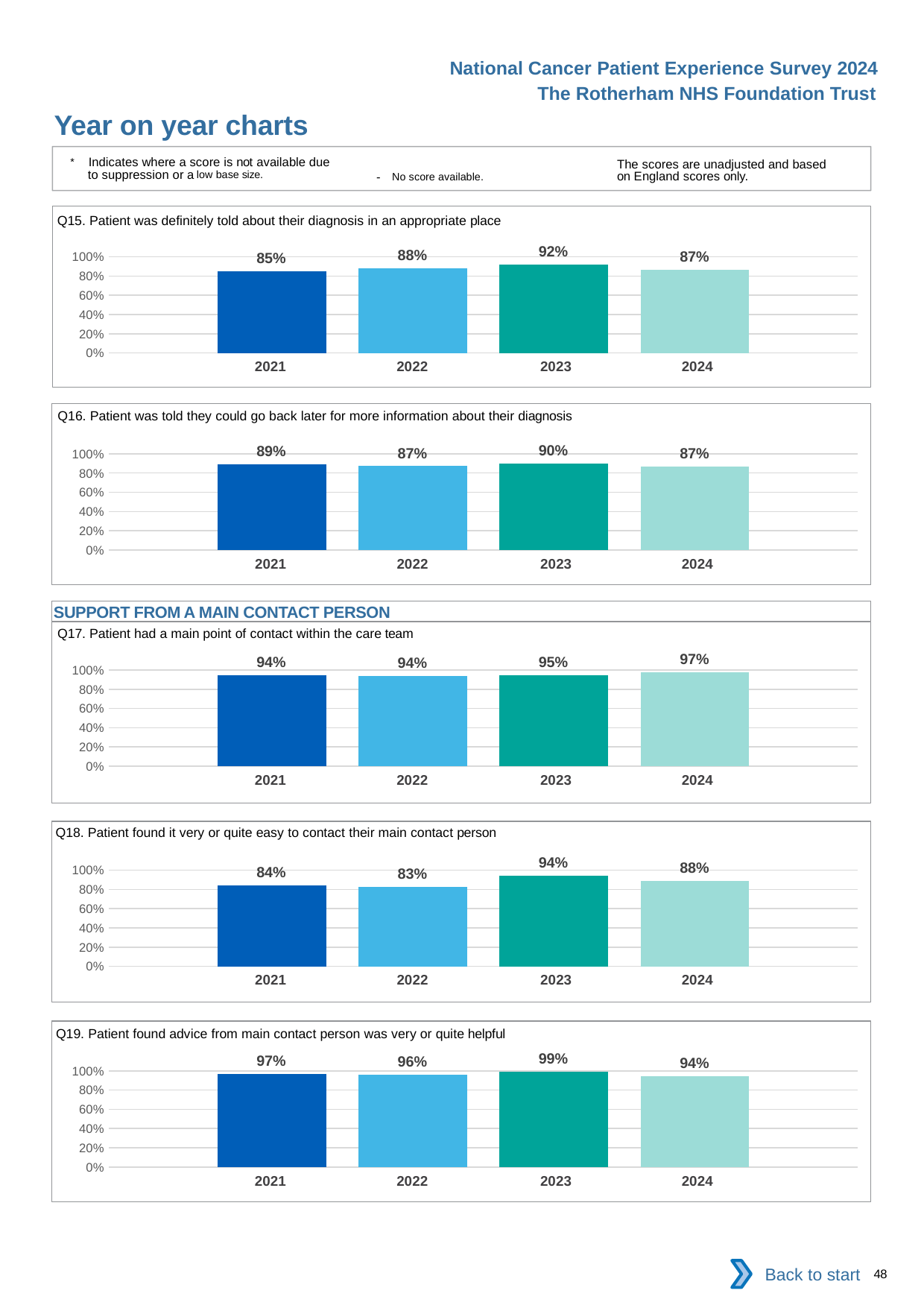
In the Q18 chart, what is the difference between the 2023 value and the 2022 value? 11% In the Q15 chart (patient was definitely told about their diagnosis in an appropriate place), what is the value for 2023? 92% In the Q16 chart, which year has the highest value? 2023 How many years are shown in the Q19 chart? 4 In the Q19 chart (patient found advice from main contact person was very or quite helpful), what is the value for 2023? 99% In the Q18 chart (patient found it very or quite easy to contact their main contact person), what is the value for 2022? 83% In the Q15 chart, which year has the lowest value? 2021 In the Q17 chart (patient had a main point of contact within the care team), what is the value for 2024? 97% What kind of chart is the Q15 chart? Bar chart In the Q16 chart (patient was told they could go back later for more information about their diagnosis), what is the value for 2021? 89% In the Q17 chart, what is the difference between the 2024 value and the 2021 value? 3% In the Q18 chart, which is larger, the value for 2023 or the value for 2024? 2023